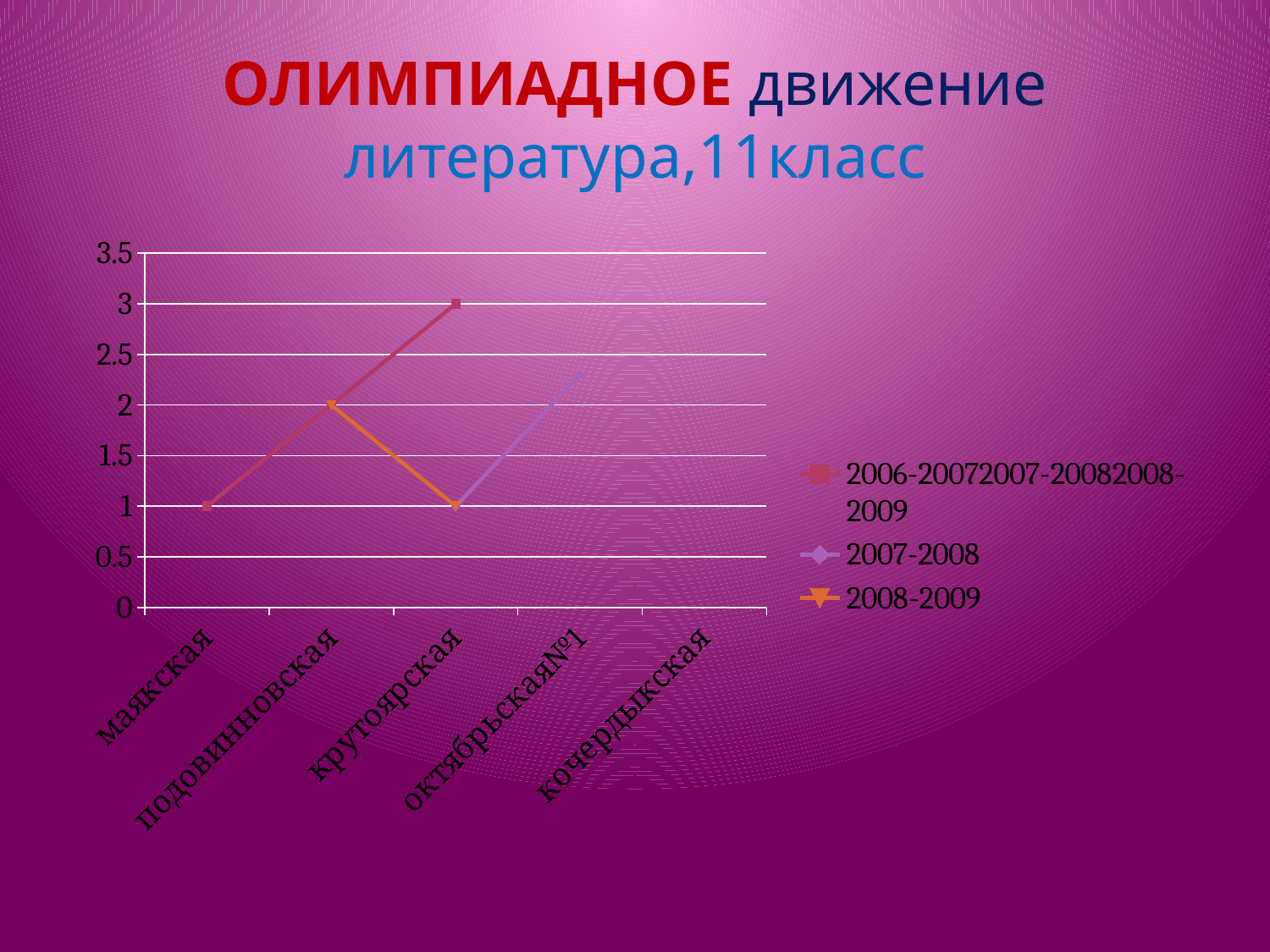
What is the value of the first (red) series for маякская? 1 Which category has the highest plotted value on the chart? крутоярская Does the first (red) series rise or fall from маякская to крутоярская? rise What is the value of the 2008-2009 series for крутоярская? 1 What is the difference between the first (red) series' values for крутоярская and маякская? 2 For крутоярская, which series has the larger value: the first (red) series or the 2008-2009 series? the first (red) series How many categories are shown on the x axis of the chart? 5 What is the value of the 2008-2009 series for подовинновская? 2 How many series does the chart legend list? 3 Is the value of the 2007-2008 series for октябрьская№1 greater or less than 2? greater What is the value of the first (red) series for крутоярская? 3 What kind of chart is shown on the slide? line chart